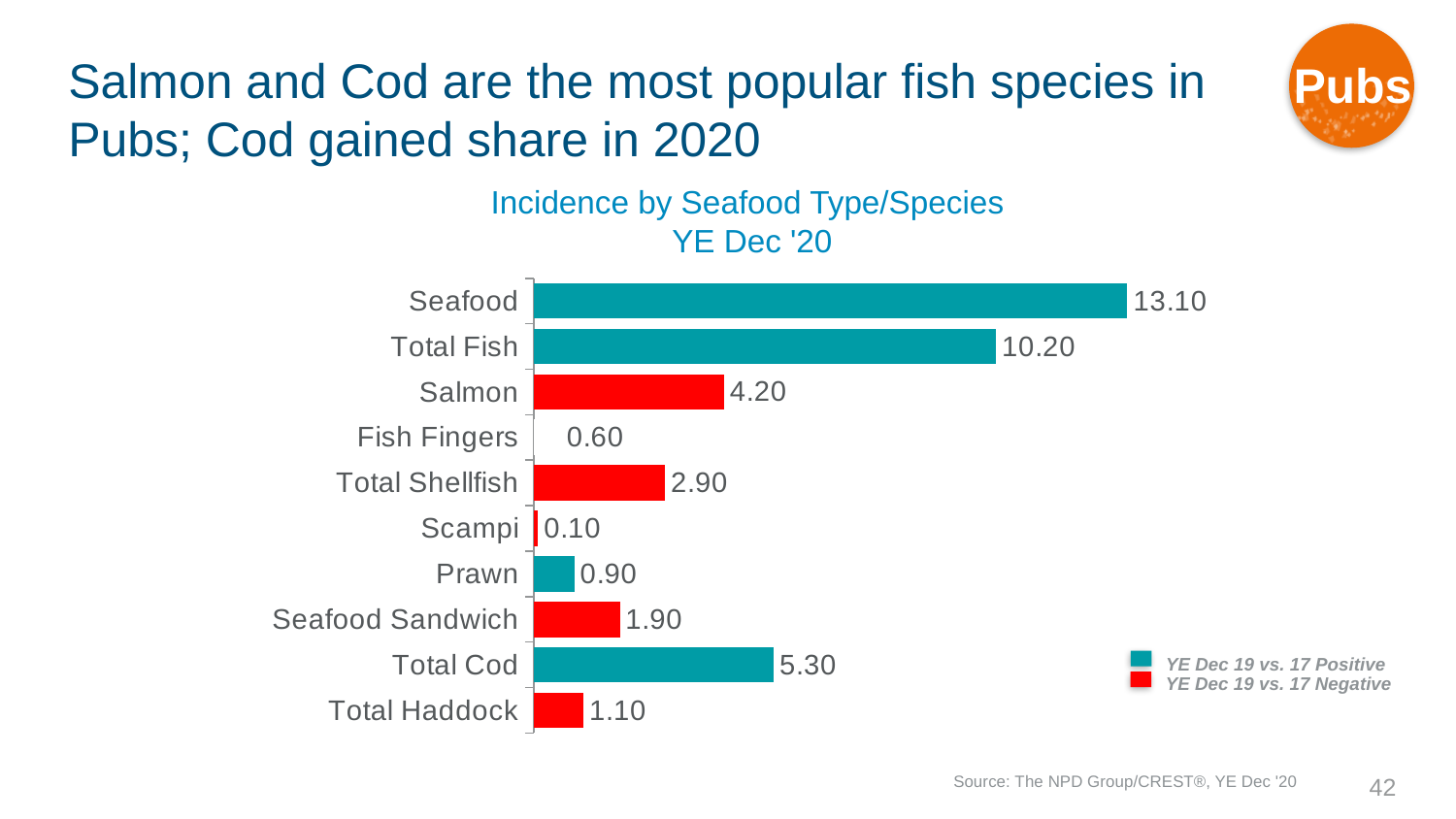
What is the value for Seafood? 13.10 What is the difference between the values for Total Cod and Total Haddock? 4.20 What kind of chart is shown on the slide? Bar chart Which category has the highest value? Seafood Which category has the lowest value? Scampi What is the value for Fish Fingers? 0.60 What is the difference between the values for Seafood and Total Fish? 2.90 What is the value for Total Cod? 5.30 What is the value for Salmon? 4.20 What is the title of the chart? Incidence by Seafood Type/Species YE Dec '20 How many categories are shown in the chart? 10 Which is larger, the value for Salmon or the value for Total Shellfish? Salmon